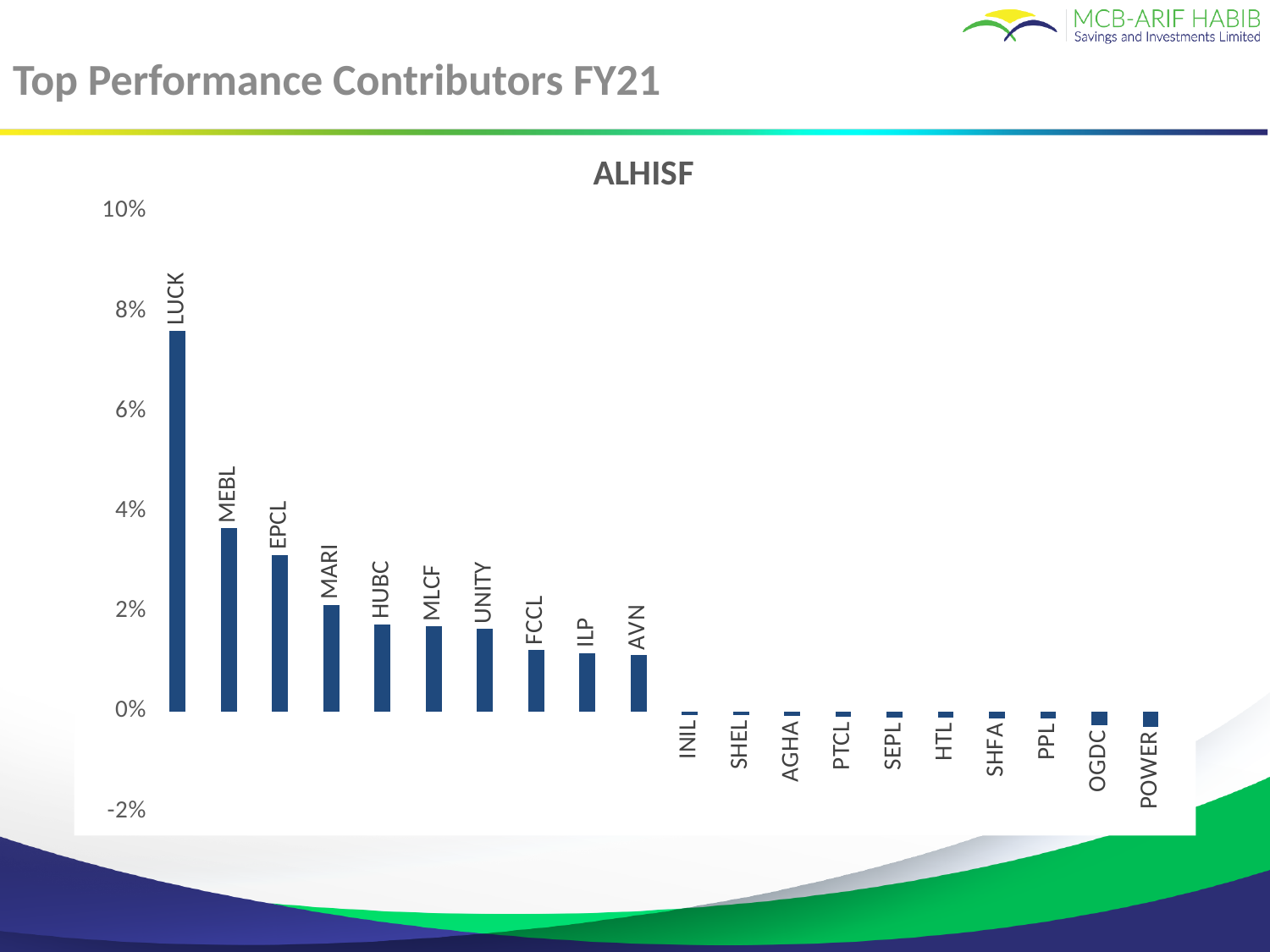
Which category has the highest value? LUCK Is the value for LUCK greater or less than 6%? greater Which is larger, the value for LUCK or the value for MEBL? LUCK What kind of chart is shown on the slide? bar chart What is the title of the chart? ALHISF Is the value for MEBL greater or less than 4%? less Is the value for HUBC greater or less than 2%? less How many categories have a negative value? 10 Which is larger, the value for MEBL or the value for EPCL? MEBL How many categories are plotted in the chart? 20 Do the values rise or fall moving from left to right along the x axis? fall